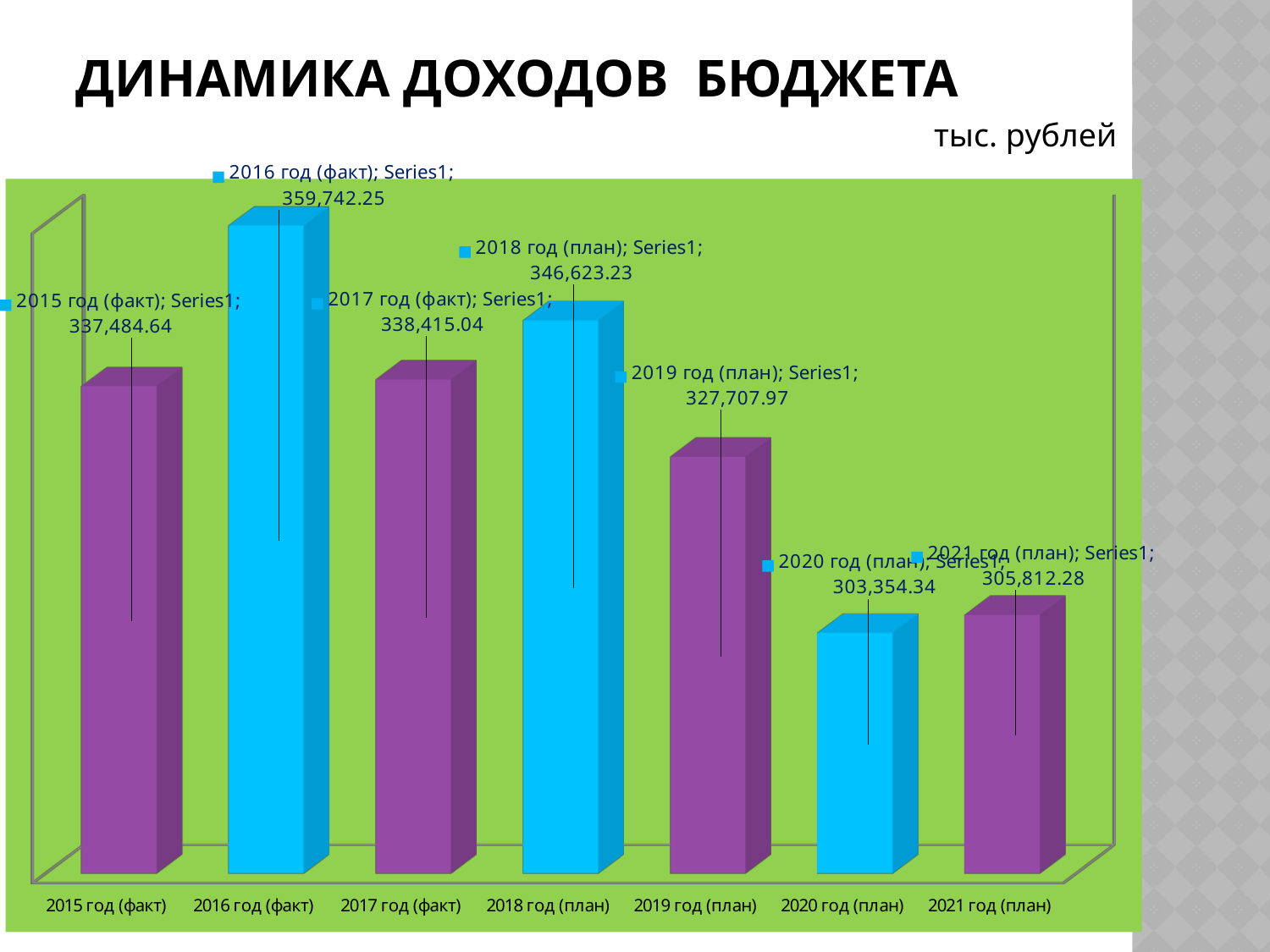
What is the value for 2021 год (план)? 305,812.28 What kind of chart is shown on the slide? bar chart What is the value for 2019 год (план)? 327,707.97 What is the title of the chart? ДИНАМИКА ДОХОДОВ БЮДЖЕТА Which year has the highest value? 2016 год (факт) What is the difference between the values for 2016 год (факт) and 2015 год (факт)? 22,257.61 Do the values rise or fall from 2018 год (план) to 2020 год (план)? fall Which is larger, the value for 2018 год (план) or 2019 год (план)? 2018 год (план) How many years are shown on the chart? 7 Which year has the lowest value? 2020 год (план) What is the value for 2016 год (факт)? 359,742.25 What is the difference between the values for 2021 год (план) and 2020 год (план)? 2,457.94